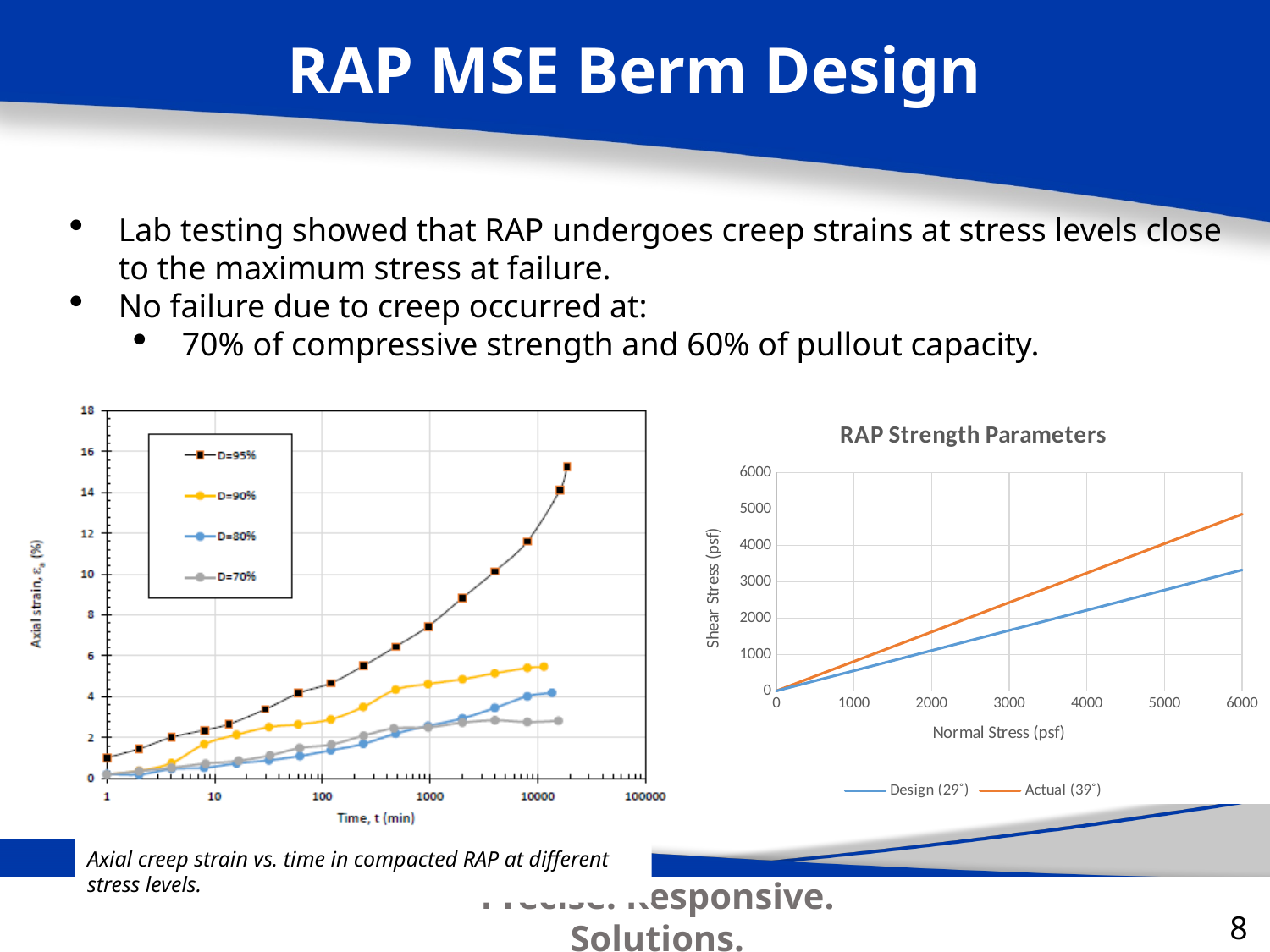
In the axial creep strain vs. time chart on the left, what is the label of the x axis? Time, t (min) In the RAP Strength Parameters chart, how many series does the legend list? 2 In the RAP Strength Parameters chart, what is the label of the y axis? Shear Stress (psf) In the RAP Strength Parameters chart, which series has the higher shear stress at a normal stress of 6000 psf? Actual (39˚) In the RAP Strength Parameters chart, do the shear stress values rise or fall as normal stress increases? rise In the RAP Strength Parameters chart, is the shear stress for Actual (39˚) at a normal stress of 6000 psf greater or less than 4000? greater In the RAP Strength Parameters chart, is the shear stress for Design (29˚) at a normal stress of 6000 psf greater or less than 4000? less In the axial creep strain vs. time chart on the left, how many series does the legend list? 4 In the axial creep strain vs. time chart on the left, which series has the lowest axial strain at the end of the test? D=70% What kind of chart is the RAP Strength Parameters chart? line chart In the axial creep strain vs. time chart on the left, which series reaches the highest axial strain? D=95%